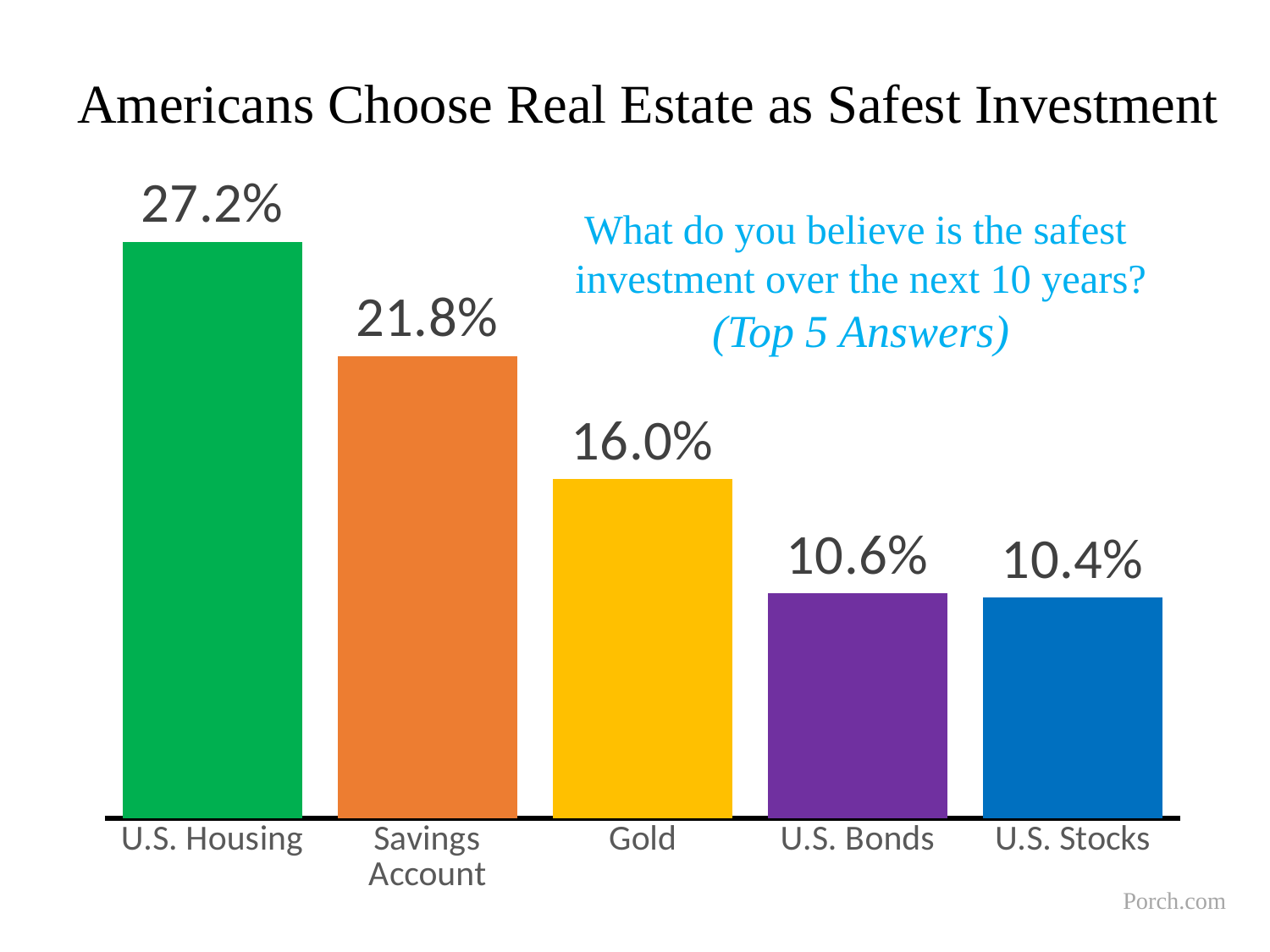
What is the difference between the values for U.S. Housing and Savings Account? 5.4% What is the difference between the values for Gold and U.S. Bonds? 5.4% How many categories are shown in the chart? 5 Do the values rise or fall from left to right across the categories? Fall Which is larger, the value for Savings Account or the value for Gold? Savings Account What percentage of respondents chose U.S. Housing as the safest investment? 27.2% What is the value shown for U.S. Stocks? 10.4% What is the value shown for Gold? 16.0% What kind of chart is shown on the slide? Bar chart Which category has the highest value? U.S. Housing What is the value shown for Savings Account? 21.8% Which category has the lowest value? U.S. Stocks